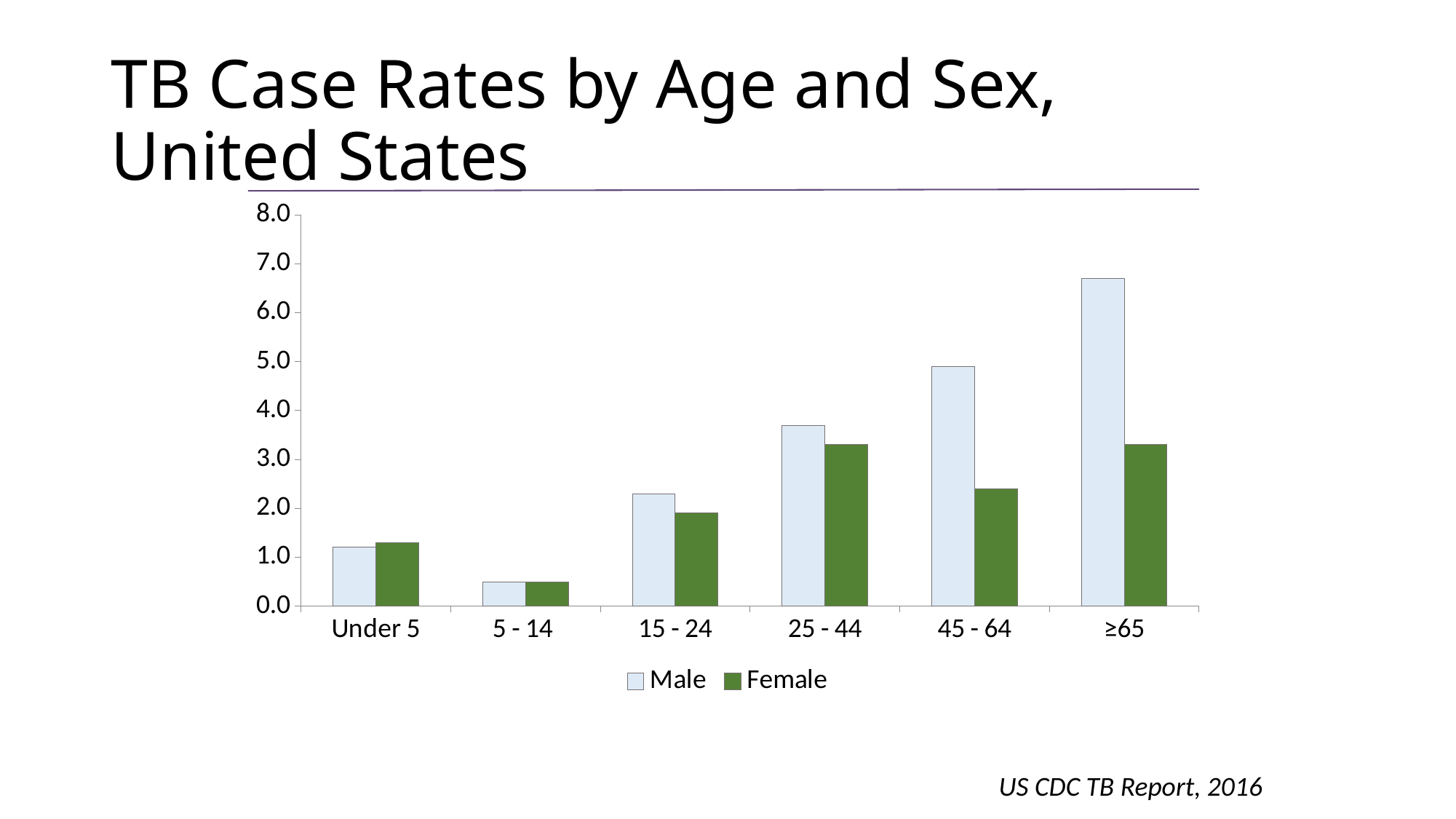
How many age groups are shown on the x axis? 6 Which age group has the highest Male value? ≥65 Is the Female value for 45 - 64 greater or less than 3.0? less What kind of chart is shown on the slide? Bar chart From the 5 - 14 age group to the ≥65 age group, do the Male values rise or fall? rise Is the Male value for ≥65 greater or less than 6.0? greater What are the two series named in the legend? Male and Female For the 45 - 64 age group, which is larger, the Male or the Female value? Male Which age group has the lowest Male value? 5 - 14 Which age group has the lowest Female value? 5 - 14 How many series does the legend list? 2 For the ≥65 age group, which is larger, the Male or the Female value? Male